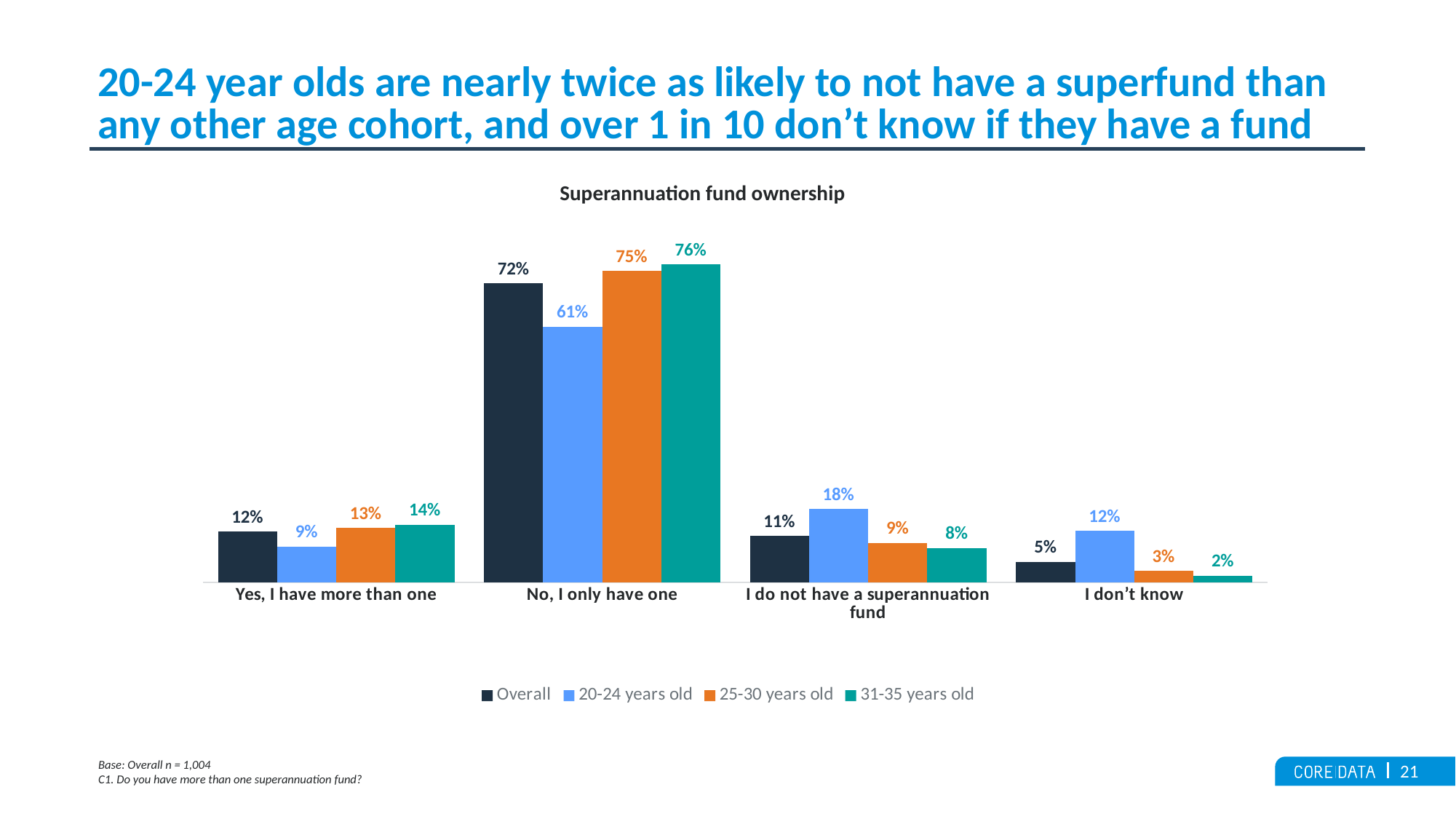
What is the value for 20-24 years old in the 'I do not have a superannuation fund' category? 18% Which age group has the highest value for 'No, I only have one'? 31-35 years old Which series has the lowest value in the 'Yes, I have more than one' category? 20-24 years old What is the value for 31-35 years old in the 'I don't know' category? 2% How many series does the legend list? 4 What kind of chart is shown on the slide? Bar chart How many categories are shown on the x axis? 4 What is the difference between the 20-24 years old and 31-35 years old values for 'I do not have a superannuation fund'? 10% Which is larger for 'I don't know': the 20-24 years old value or the 25-30 years old value? 20-24 years old What is the title of the chart? Superannuation fund ownership What is the difference between the 25-30 years old and 20-24 years old values for 'No, I only have one'? 14% What is the Overall value for 'No, I only have one'? 72%